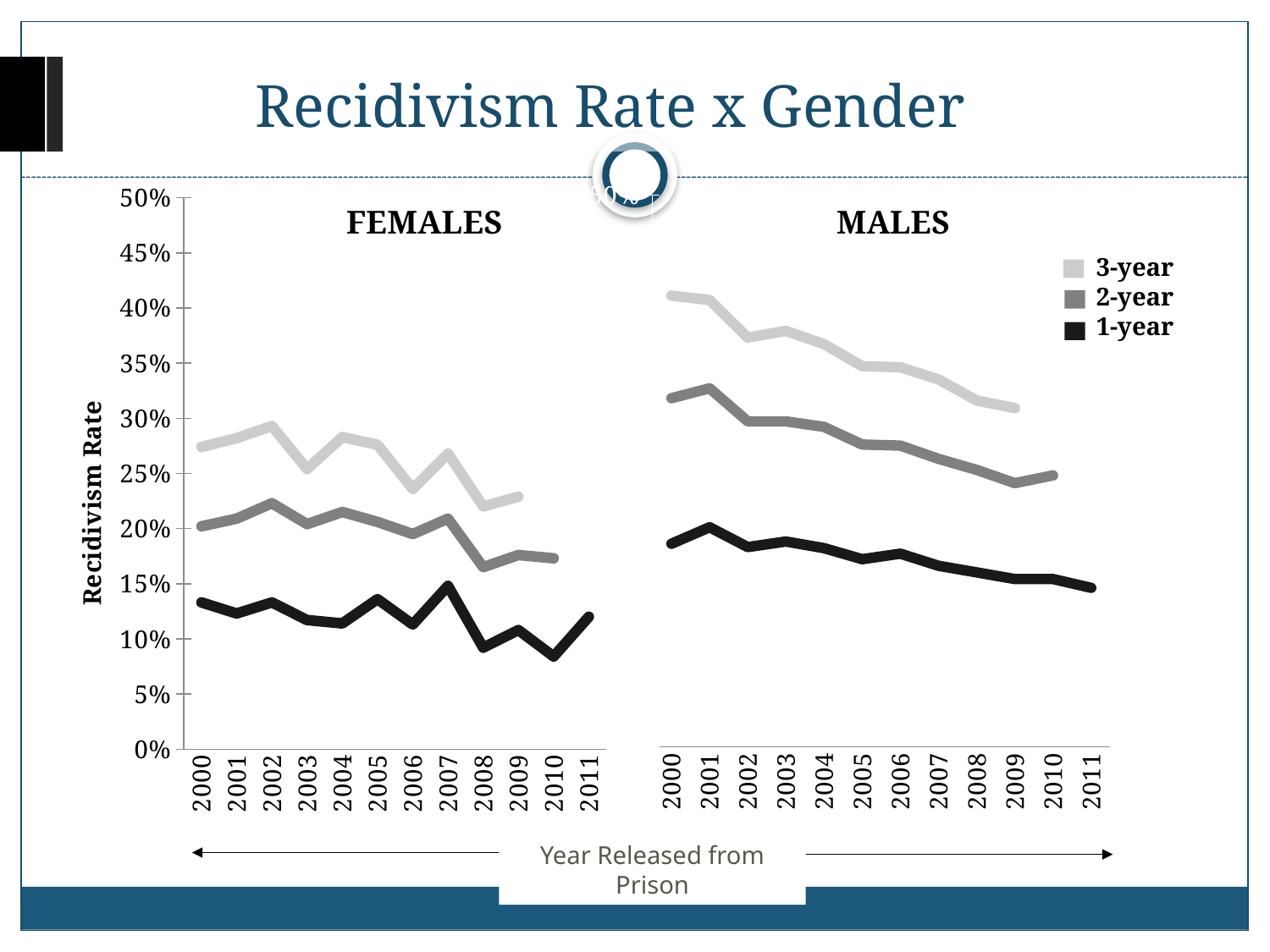
In the MALES panel, does the 1-year recidivism rate rise or fall from 2001 to 2011? fall In the FEMALES panel, is the 1-year recidivism rate for 2010 greater or less than 10%? less How many release years are plotted on the x axis of the FEMALES panel? 12 In the MALES panel, is the 3-year recidivism rate for 2002 greater or less than 35%? greater In the FEMALES panel, is the 3-year recidivism rate for 2000 greater or less than 25%? greater What kind of chart is shown on the slide? line chart How many series does the legend list? 3 In the MALES panel, does the 3-year recidivism rate rise or fall from 2000 to 2009? fall Which is larger for 2000: the 3-year recidivism rate for MALES or for FEMALES? MALES What is the title of the chart on the slide? Recidivism Rate x Gender In the FEMALES panel, which release year has the highest 1-year recidivism rate? 2007